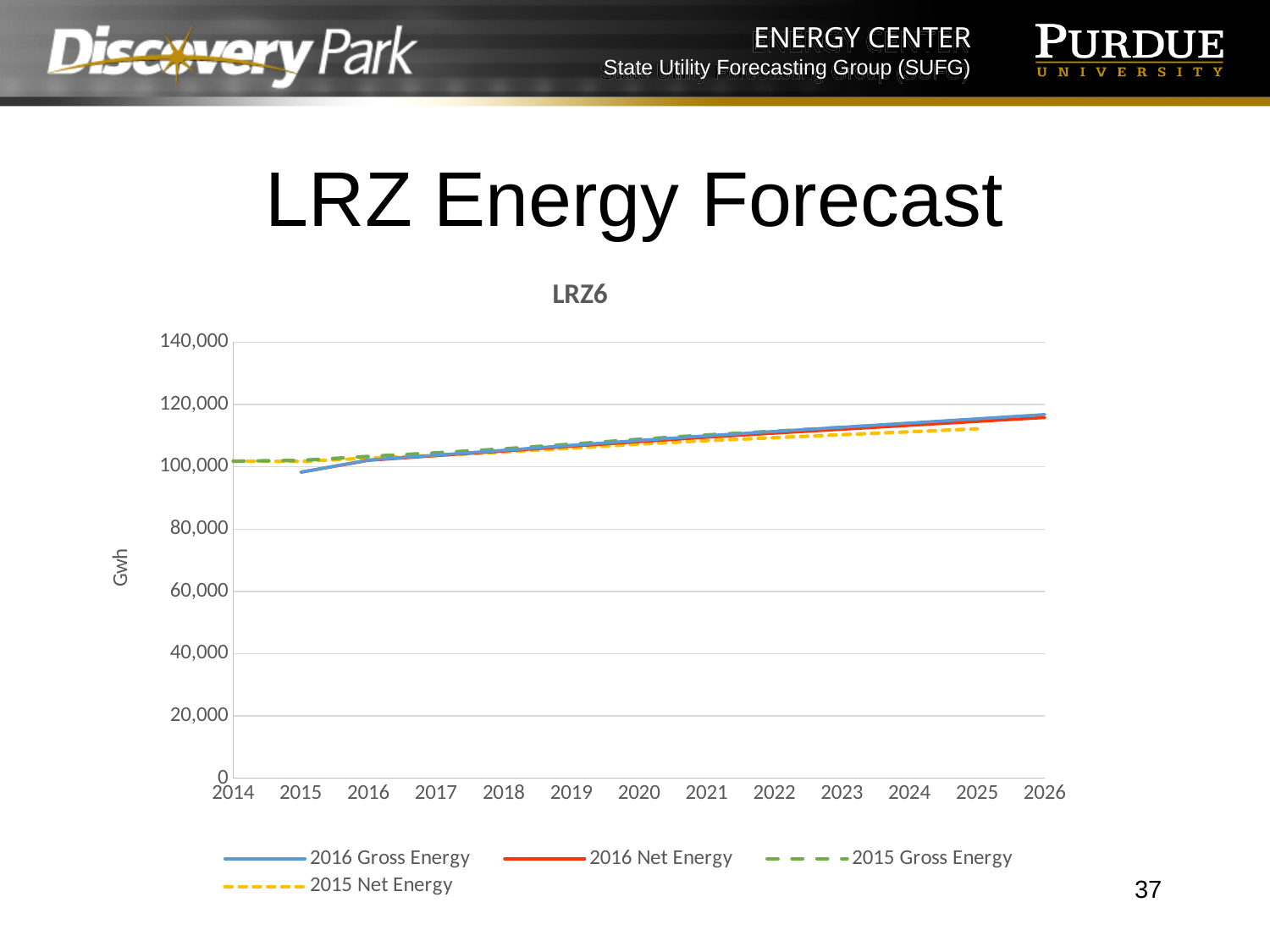
What kind of chart is shown on the slide? line chart How many series does the legend list? 4 Does the 2015 Net Energy line rise or fall from 2014 to 2025? rise Is the value for 2016 Gross Energy in 2015 greater or less than 100,000? less What is the title of the chart? LRZ6 Is the value for 2016 Gross Energy in 2026 greater or less than 100,000? greater Is the value for 2015 Net Energy in 2025 greater or less than 120,000? less What is the label on the vertical axis? Gwh Which series has the lowest value in 2015? 2016 Gross Energy and 2016 Net Energy (tied) How many years are marked on the x axis? 13 Does the 2016 Gross Energy line rise or fall from 2015 to 2026? rise